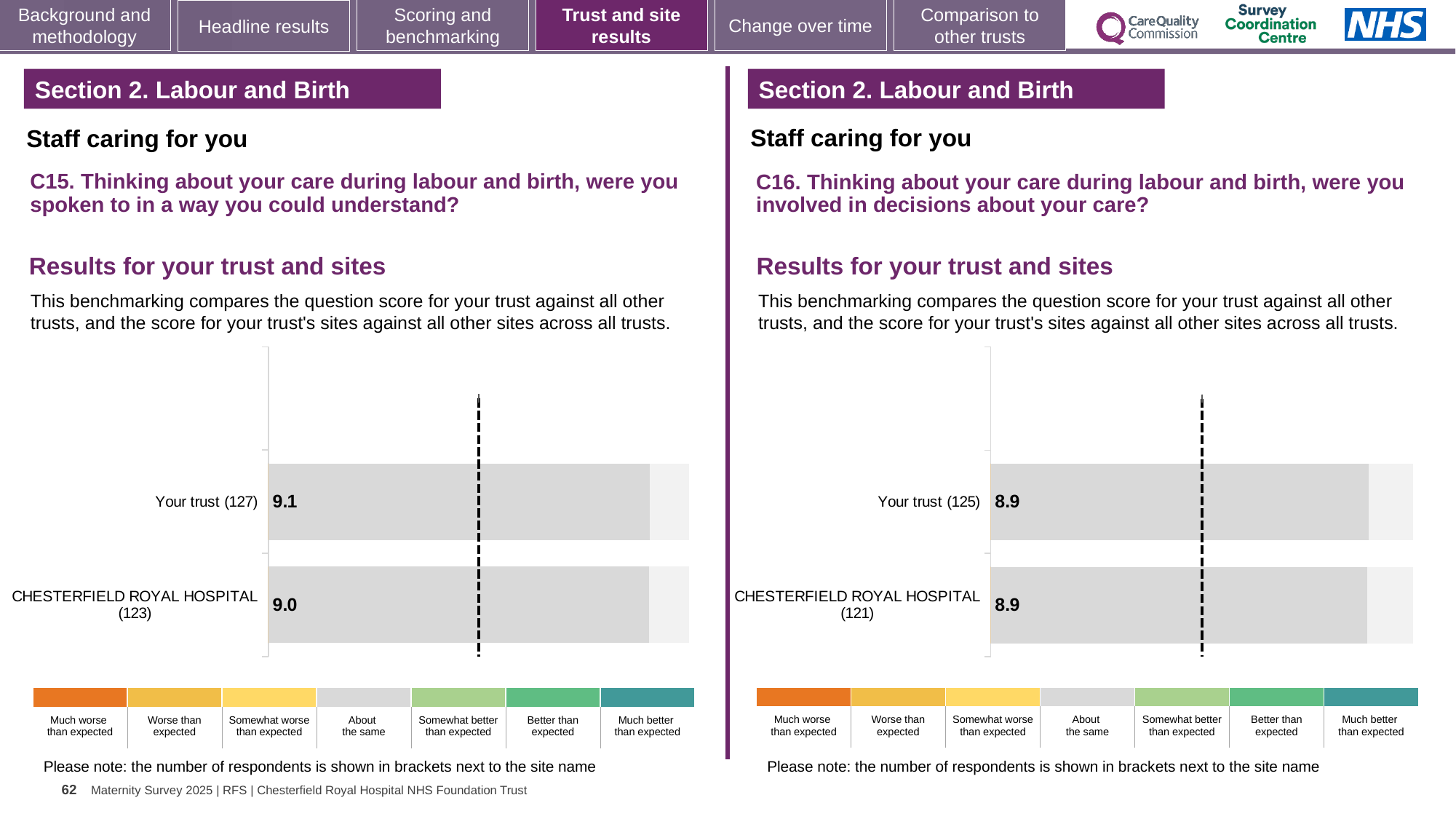
On the right chart (C16), how many respondents are shown in brackets for Your trust? 125 On the left chart (C15), what is the score for Chesterfield Royal Hospital? 9.0 On the right chart (C16), what is the difference between the score for Your trust and the score for Chesterfield Royal Hospital? 0 On the right chart (C16), what is the score for Your trust? 8.9 On the left chart (C15), what is the score for Your trust? 9.1 On the left chart (C15), which category has the lowest score? Chesterfield Royal Hospital On the left chart (C15), how many respondents are shown in brackets for Chesterfield Royal Hospital? 123 On the left chart (C15), which has the higher score, Your trust or Chesterfield Royal Hospital? Your trust What type of chart is used on the right (C16)? Bar chart On the right chart (C16), what is the score for Chesterfield Royal Hospital? 8.9 On the left chart (C15), what is the difference between the score for Your trust and the score for Chesterfield Royal Hospital? 0.1 How many bars are plotted on the left chart (C15)? 2